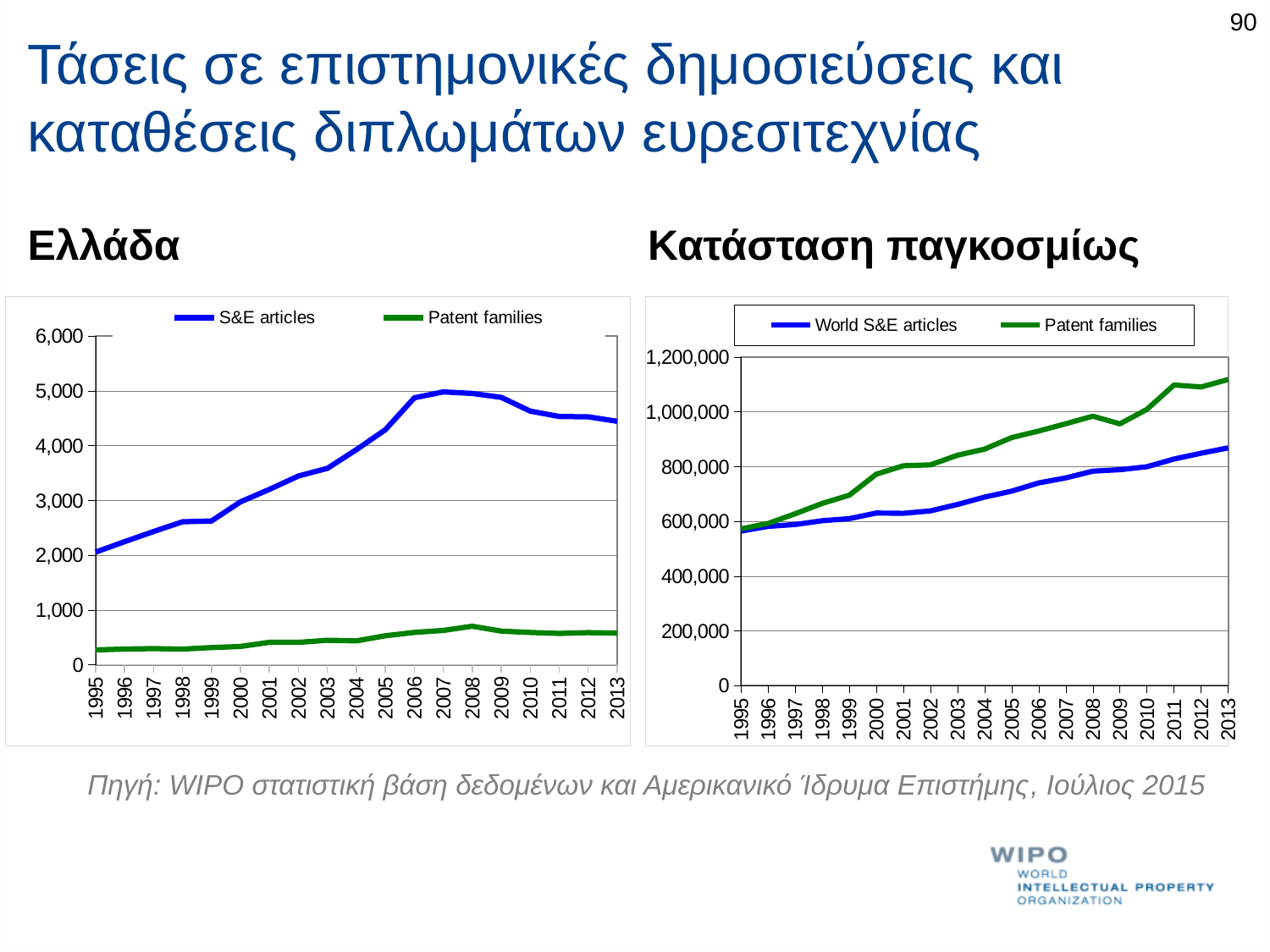
In the left chart ('Ελλάδα'), how many years are shown on the x axis? 19 In the left chart ('Ελλάδα'), is the value for S&E articles in 2013 greater or less than 4,000? greater In the right chart ('Κατάσταση παγκοσμίως'), in which year is the value for Patent families highest? 2013 In the left chart ('Ελλάδα'), which series is shown in green? Patent families In the right chart ('Κατάσταση παγκοσμίως'), which series has the larger value in 2013, World S&E articles or Patent families? Patent families In the left chart ('Ελλάδα'), is the value for Patent families in 2008 greater or less than 1,000? less How many series does the legend of the right chart ('Κατάσταση παγκοσμίως') list? 2 In the left chart ('Ελλάδα'), which series has the larger value in 2013, S&E articles or Patent families? S&E articles In the right chart ('Κατάσταση παγκοσμίως'), do the values for World S&E articles rise or fall from 1995 to 2013? rise In the right chart ('Κατάσταση παγκοσμίως'), is the value for Patent families in 2013 greater or less than 1,000,000? greater What kind of chart is the left chart titled 'Ελλάδα'? line chart